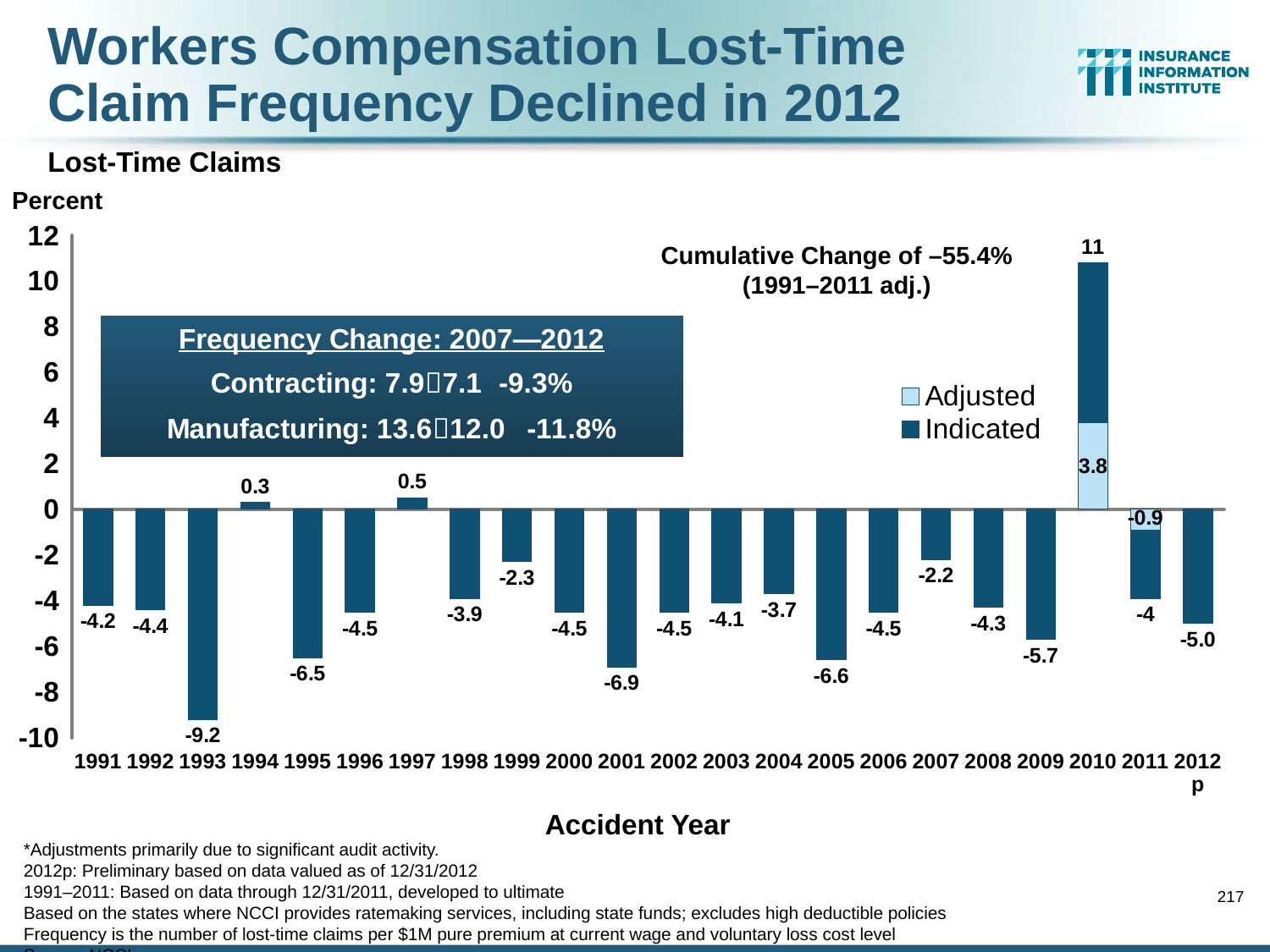
What is the Indicated value for 2010? 11 What is the difference between the values for 2001 and 1999? 4.6 How many accident years are shown on the x axis? 22 What is the Adjusted value for 2010? 3.8 What is the value for 1993? -9.2 What kind of chart is shown? Bar chart How many series does the legend list? 2 Which accident year has the lowest value? 1993 What is the value for 2012p? -5.0 What cumulative change for 1991–2011 (adj.) is stated on the chart? –55.4% Which is larger, the value for 1994 or the value for 1997? 1997 Which accident year has the highest value? 2010